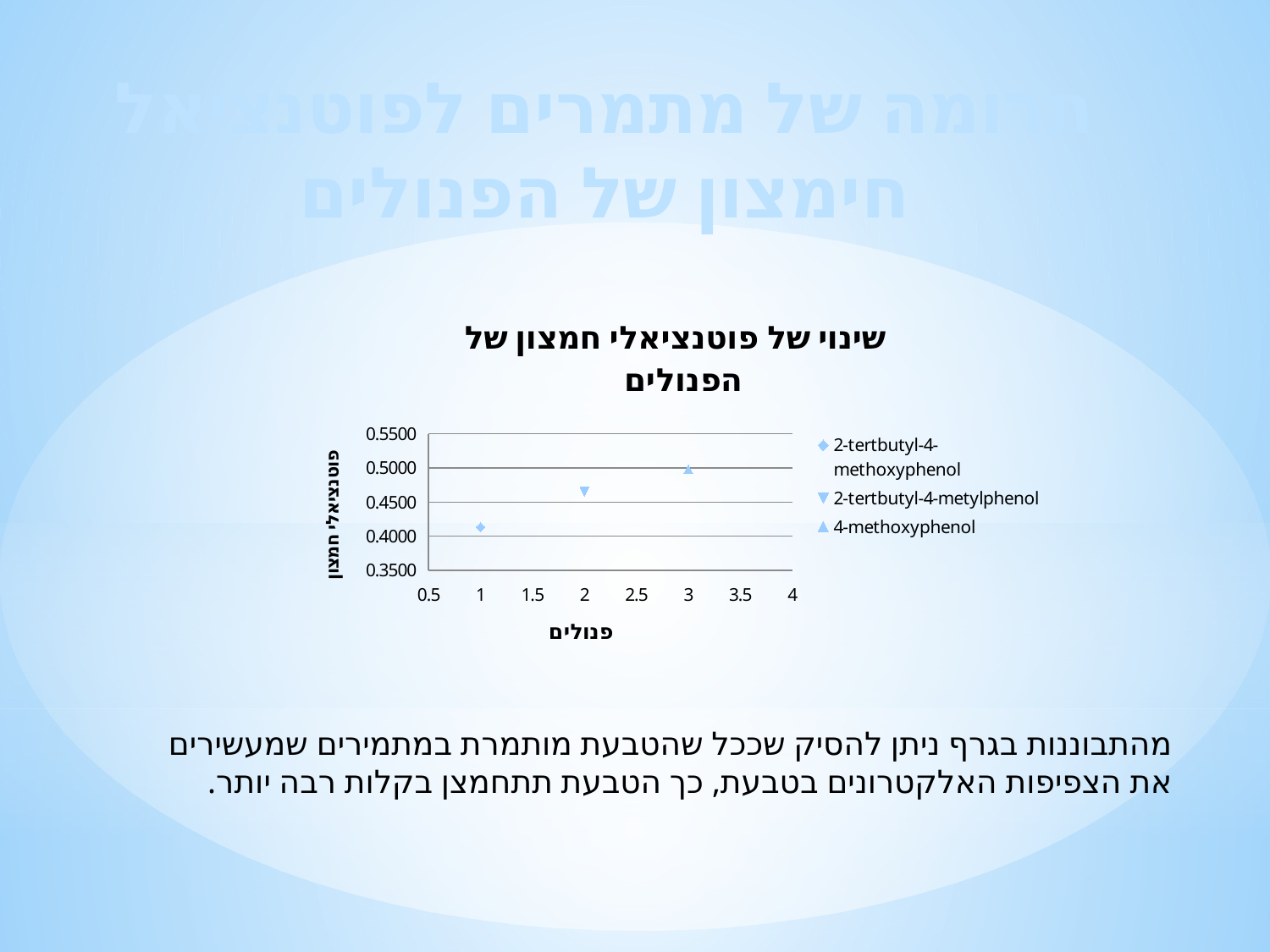
Is the value for 2-tertbutyl-4-metylphenol greater or less than 0.4500? greater How many series does the legend list? 3 Which series has the lowest plotted value? 2-tertbutyl-4-methoxyphenol Which is larger, the value for 4-methoxyphenol or the value for 2-tertbutyl-4-methoxyphenol? 4-methoxyphenol What is the title of the chart? שינוי של פוטנציאלי חמצון של הפנולים What is the label of the x axis? פנולים What kind of chart is shown on the slide? scatter chart Which series has the highest plotted value? 4-methoxyphenol Is the value for 2-tertbutyl-4-methoxyphenol greater or less than 0.4500? less How many data points are plotted on the chart? 3 Is the value for 4-methoxyphenol greater or less than 0.4500? greater Do the plotted values rise or fall as you move from left to right along the x axis? rise